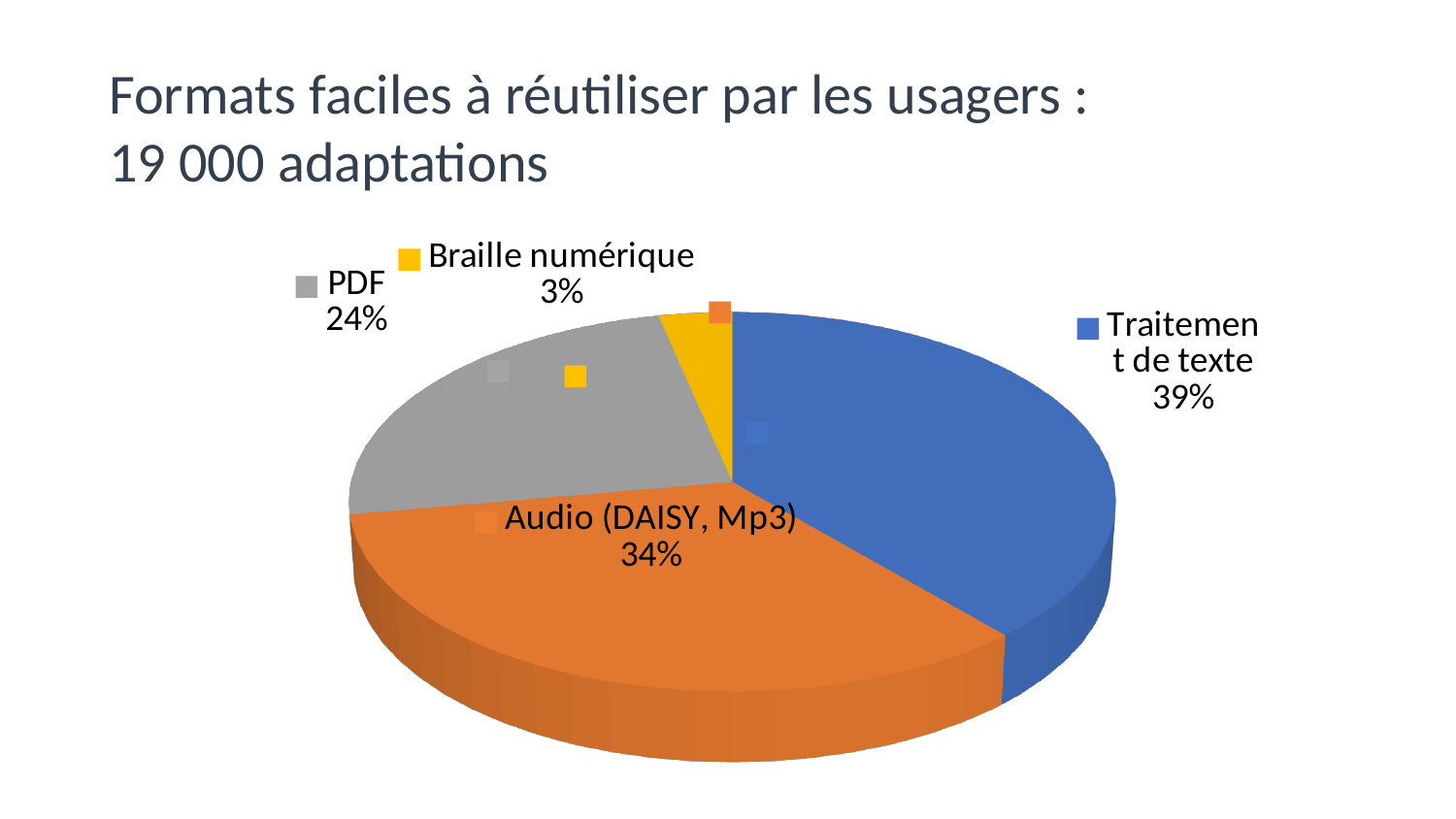
What is the title of the slide containing the chart? Formats faciles à réutiliser par les usagers : 19 000 adaptations Which format has the largest slice of the pie? Traitement de texte What is the difference in percentage points between Audio (DAISY, Mp3) and Braille numérique? 31 Which is larger, the share for PDF or the share for Audio (DAISY, Mp3)? Audio (DAISY, Mp3) What is the difference in percentage points between Traitement de texte and PDF? 15 What kind of chart is shown on the slide? Pie chart Which format has the smallest slice of the pie? Braille numérique How many slices does the pie chart have? 4 What share of the pie does Traitement de texte represent? 39% What share of the pie does Audio (DAISY, Mp3) represent? 34% What share of the pie does PDF represent? 24%